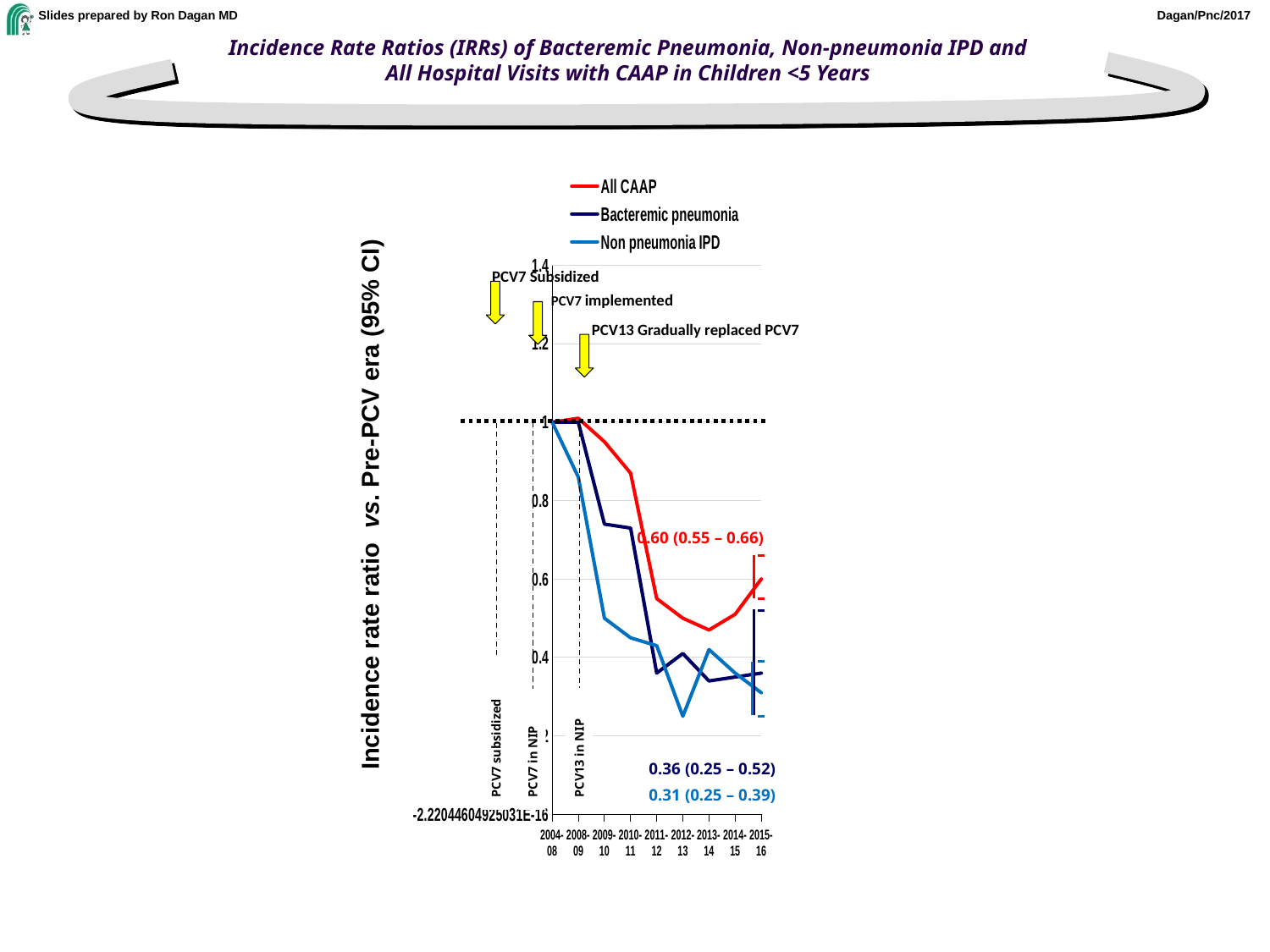
Does the All CAAP line rise or fall from 2004-08 to 2013-14? fall Which series has the lowest incidence rate ratio in 2015-16? Non pneumonia IPD What kind of chart is shown on the slide? line chart What is the incidence rate ratio for Bacteremic pneumonia in 2015-16? 0.36 Is the value for All CAAP in 2010-11 greater or less than 0.8? greater How many series does the legend list? 3 What is the difference between the 2015-16 incidence rate ratios for All CAAP and Non pneumonia IPD? 0.29 Which series has the highest incidence rate ratio in 2015-16? All CAAP How many time periods are shown on the x axis? 9 What colour is the All CAAP line? red What is the incidence rate ratio for All CAAP in 2015-16? 0.60 What is the 95% CI for Non pneumonia IPD in 2015-16? 0.25 – 0.39